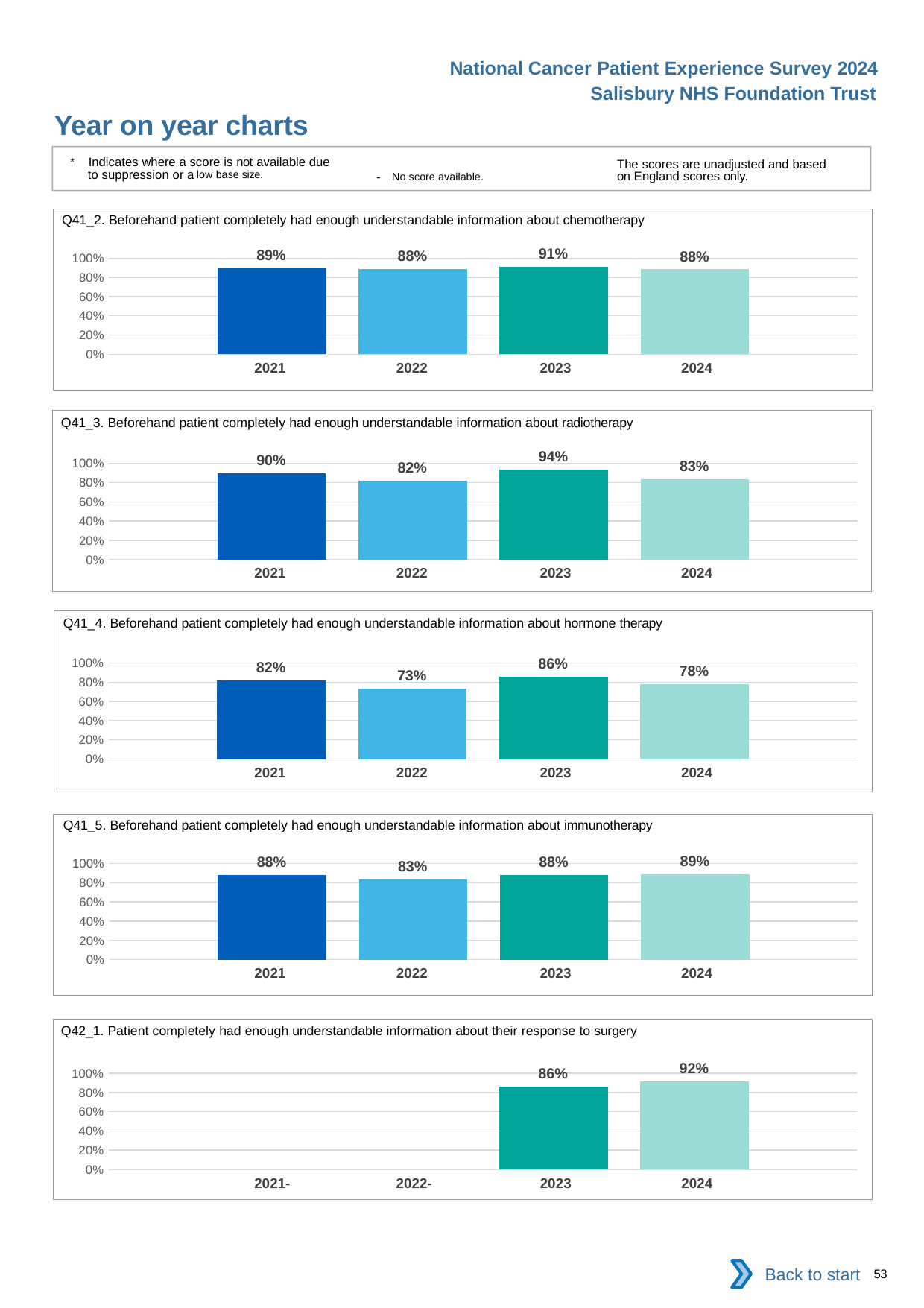
What kind of chart is the Q41_2 chart (chemotherapy)? Bar chart In the Q41_4 chart (hormone therapy), what is the difference between the 2023 and 2022 values? 13% How many charts are shown on the slide? 5 In the Q42_1 chart (response to surgery), what is the value for 2024? 92% In the Q41_5 chart (immunotherapy), what is the value for 2022? 83% In the Q41_2 chart (chemotherapy), what is the value for 2023? 91% In the Q41_3 chart (radiotherapy), which year has the highest value? 2023 In the Q41_3 chart (radiotherapy), which year has the lowest value? 2022 In the Q41_3 chart (radiotherapy), what is the difference between the 2021 and 2024 values? 7% In the Q42_1 chart (response to surgery), how many years have a plotted bar? 2 In the Q42_1 chart (response to surgery), does the value rise or fall from 2023 to 2024? Rise In the Q41_4 chart (hormone therapy), which is larger, the value for 2021 or the value for 2024? 2021